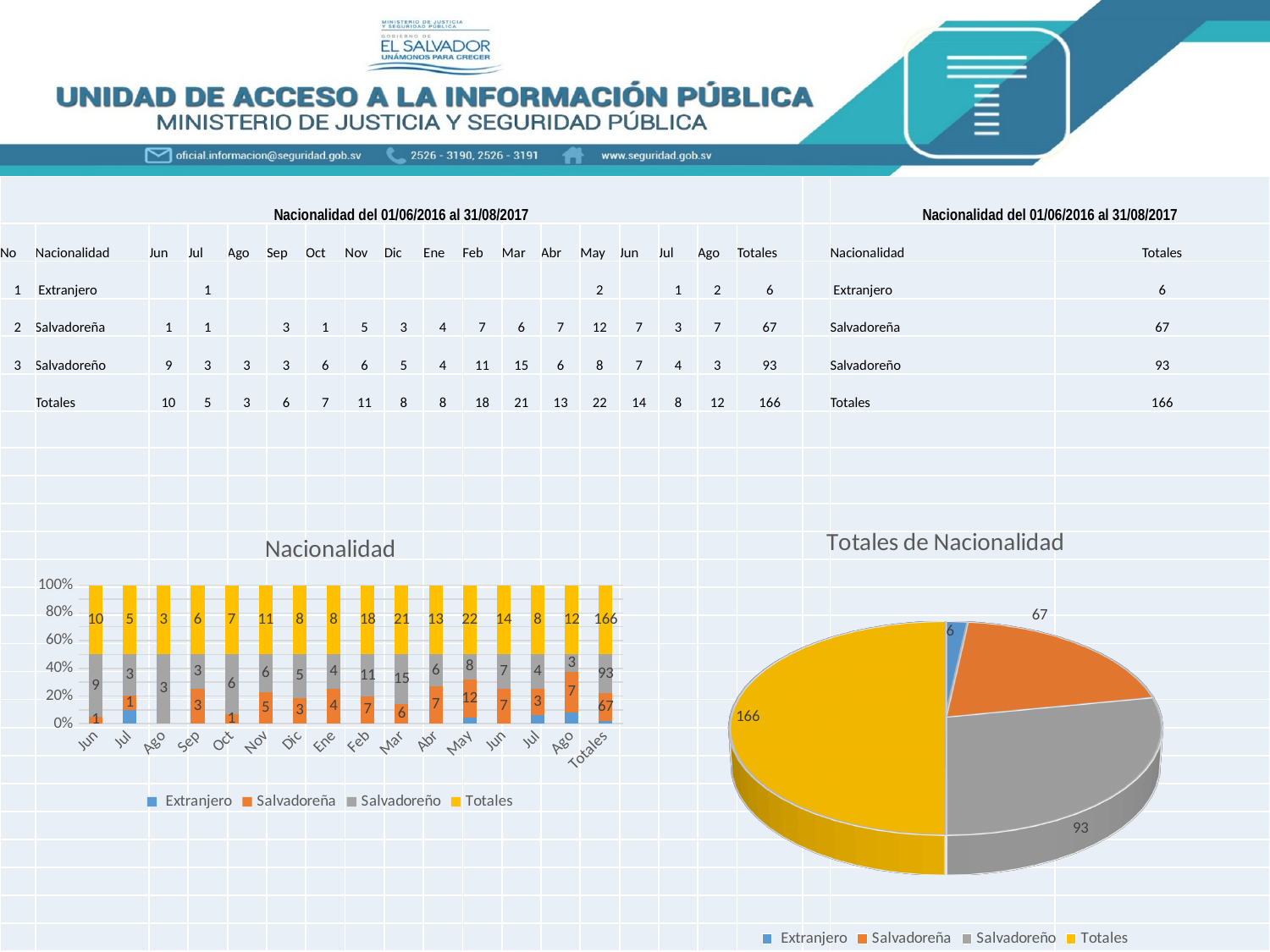
In the "Totales de Nacionalidad" pie chart, what share of the pie does the Totales slice represent? 50% In the "Totales de Nacionalidad" pie chart, which slice is the largest? Totales What kind of chart is the "Nacionalidad" chart on the left? bar chart In the "Nacionalidad" bar chart, what is the Totales value for Mar? 21 In the "Totales de Nacionalidad" pie chart, which slice is the smallest? Extranjero In the "Nacionalidad" bar chart, what is the Salvadoreño value for Feb? 11 In the "Nacionalidad" bar chart, how many categories are shown on the x axis? 16 In the "Totales de Nacionalidad" pie chart, what is the difference between the Salvadoreño and Salvadoreña slices? 26 In the "Totales de Nacionalidad" pie chart, what is the value of the Salvadoreño slice? 93 What kind of chart is the "Totales de Nacionalidad" chart on the right? pie chart In the "Nacionalidad" bar chart, how many series does the legend list? 4 In the "Totales de Nacionalidad" pie chart, which is larger, Salvadoreña or Extranjero? Salvadoreña